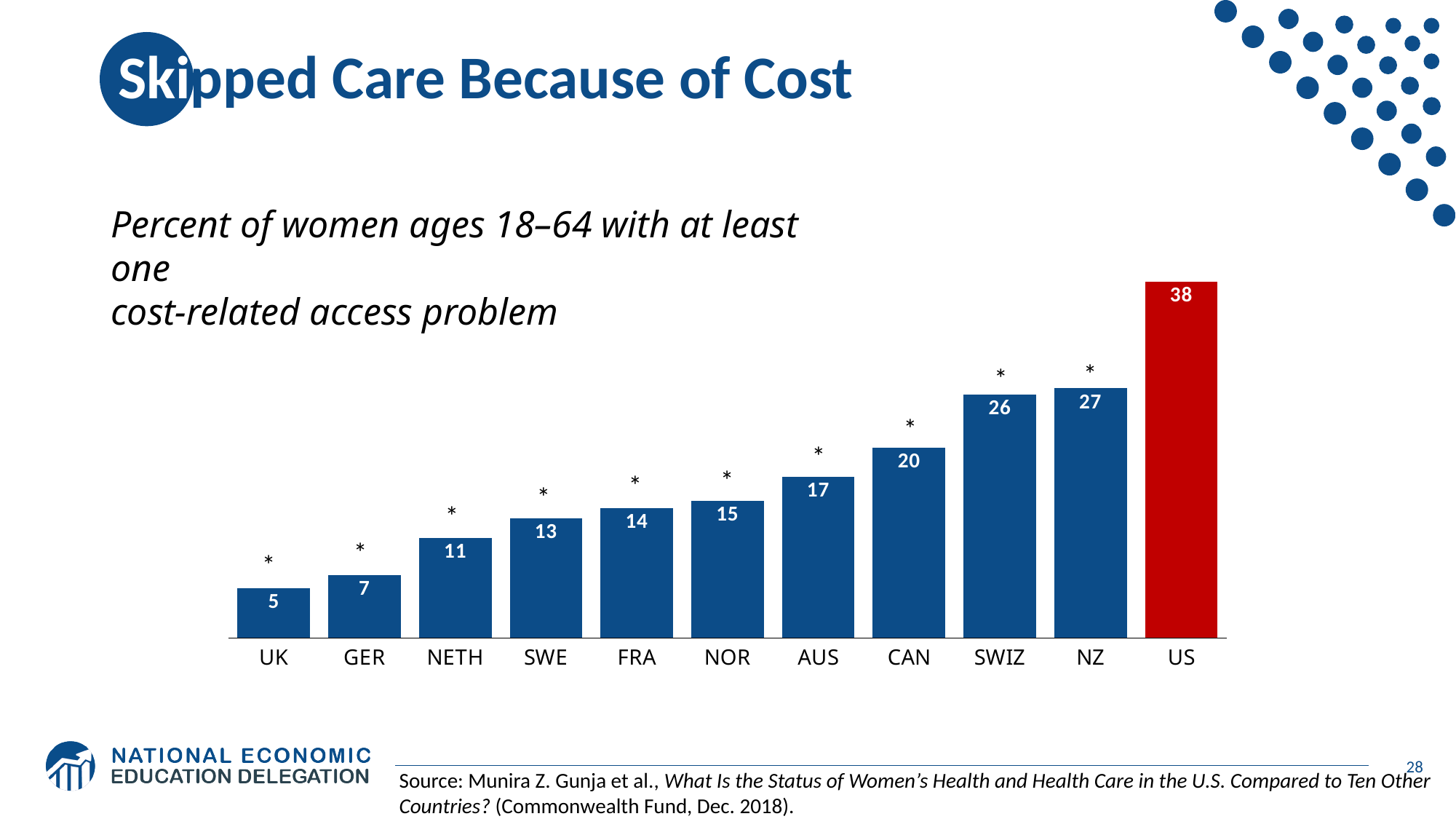
Which country has the highest value? US Which is larger, the value for AUS or the value for FRA? AUS How many countries are shown on the chart? 11 Which bar is coloured red rather than blue? US What is the difference between the values for SWIZ and UK? 21 What is the difference between the values for the US and NZ? 11 What kind of chart is shown on the slide? Bar chart What is the value for Canada (CAN)? 20 What is the value for the US? 38 Do the values rise or fall from left to right along the x axis? Rise What is the value for Germany (GER)? 7 Which country has the lowest value? UK